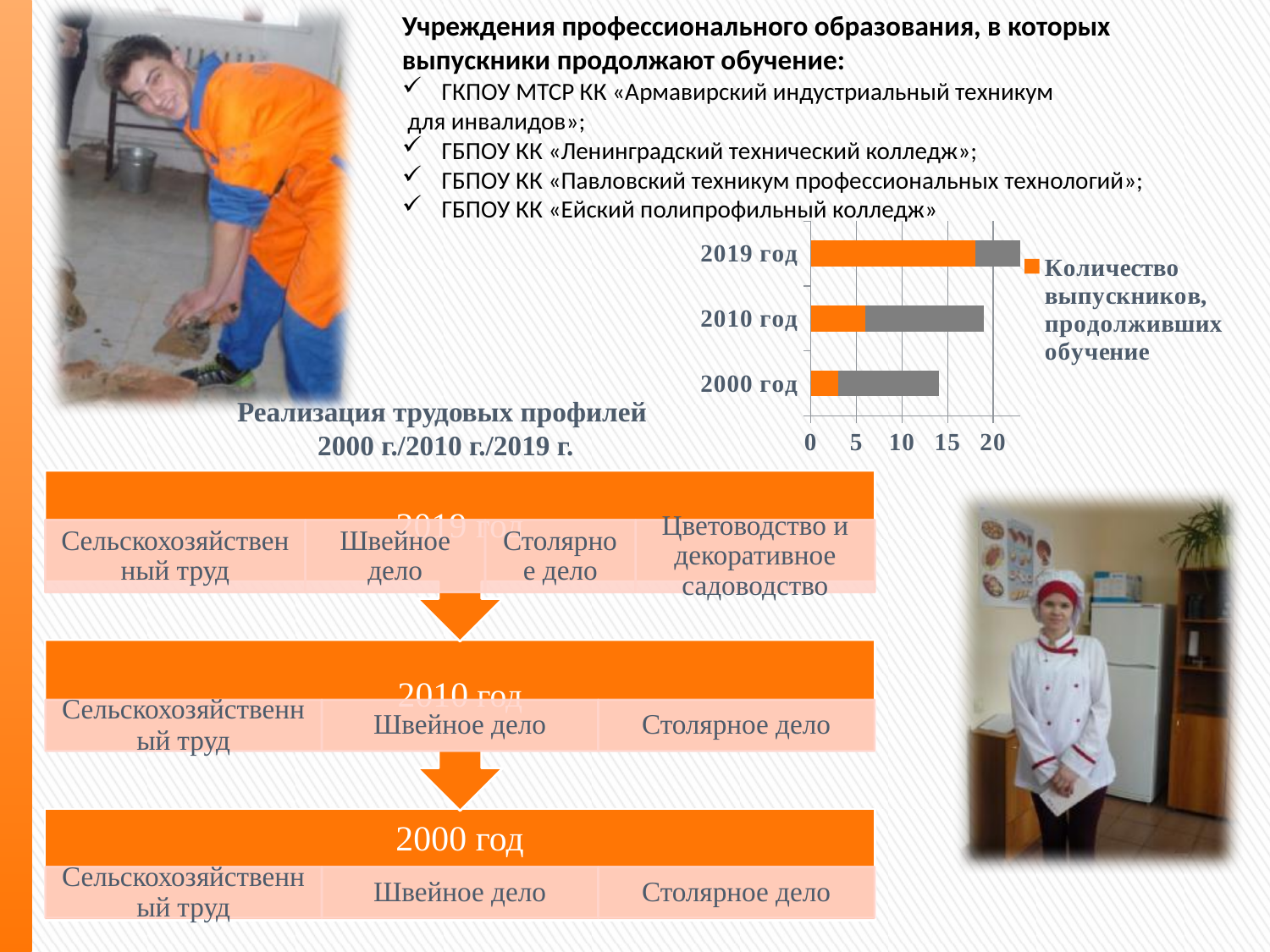
Which is larger: the value for "Количество выпускников, продолживших обучение" in 2019 год or in 2010 год? 2019 год What kind of chart is shown on the slide? bar chart Is the value for "Количество выпускников, продолживших обучение" in 2010 год greater or less than 10? less Is the value for "Количество выпускников, продолживших обучение" in 2000 год greater or less than 5? less Which year has the highest value for "Количество выпускников, продолживших обучение"? 2019 год How many categories (years) does the chart show? 3 Is the total length of the stacked bar for 2019 год greater or less than 20? greater Which year has the lowest value for "Количество выпускников, продолживших обучение"? 2000 год How many series does the chart's legend list? 1 What colour represents "Количество выпускников, продолживших обучение" in the chart? orange Does the value for "Количество выпускников, продолживших обучение" rise or fall from 2000 год to 2019 год? rise